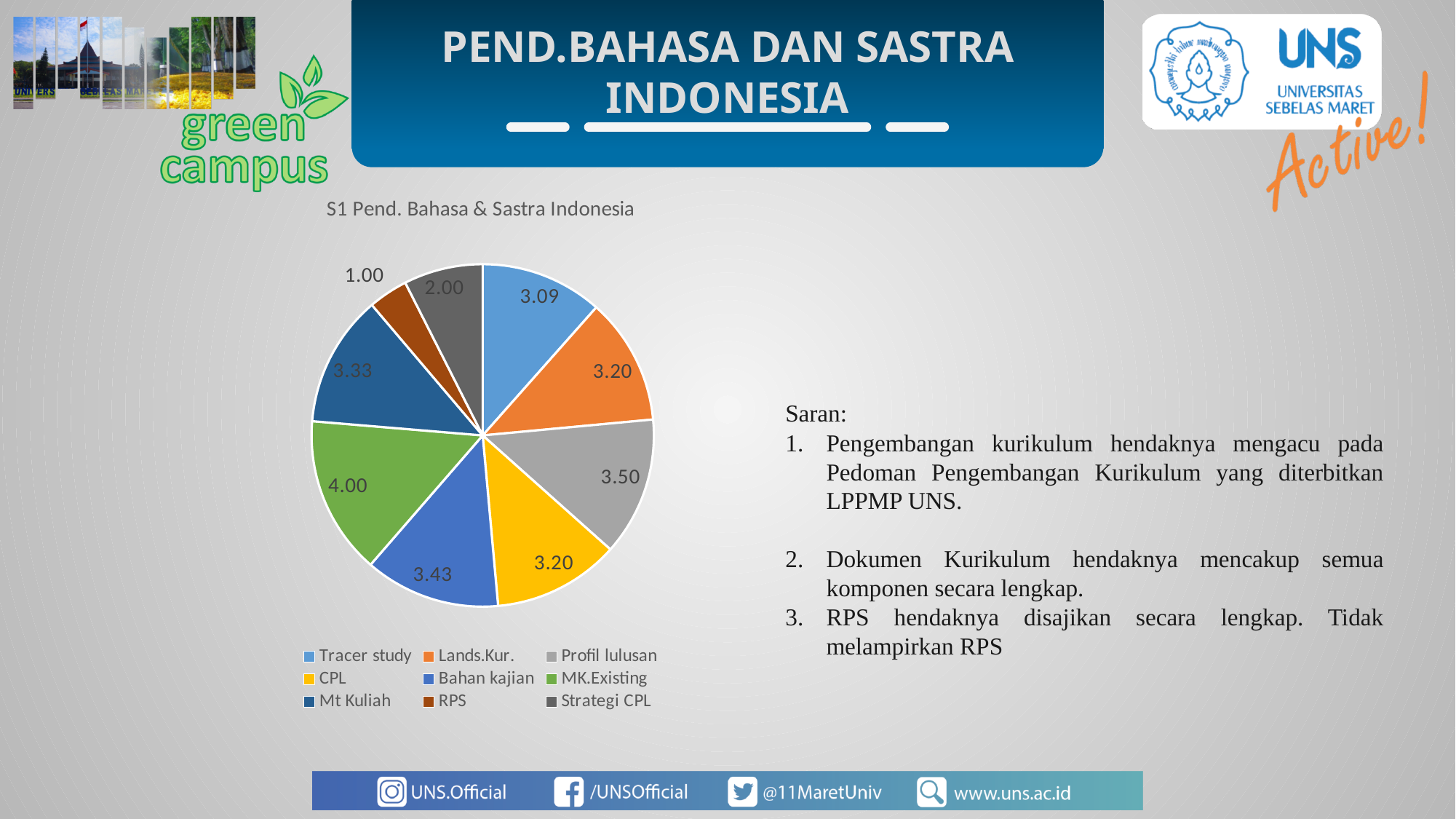
What is the value for MK.Existing in the pie chart? 4.00 What is the value for Tracer study in the pie chart? 3.09 What is the value for RPS in the pie chart? 1.00 Which category has the largest slice in the pie chart? MK.Existing What is the value for Bahan kajian in the pie chart? 3.43 Which category has the smallest slice in the pie chart? RPS What is the difference between the values for MK.Existing and Strategi CPL? 2.00 What type of chart is shown on the slide? Pie chart What is the title of the pie chart? S1 Pend. Bahasa & Sastra Indonesia Which is larger, the value for Mt Kuliah or the value for Tracer study? Mt Kuliah What is the value for Profil lulusan in the pie chart? 3.50 How many slices does the pie chart have? 9